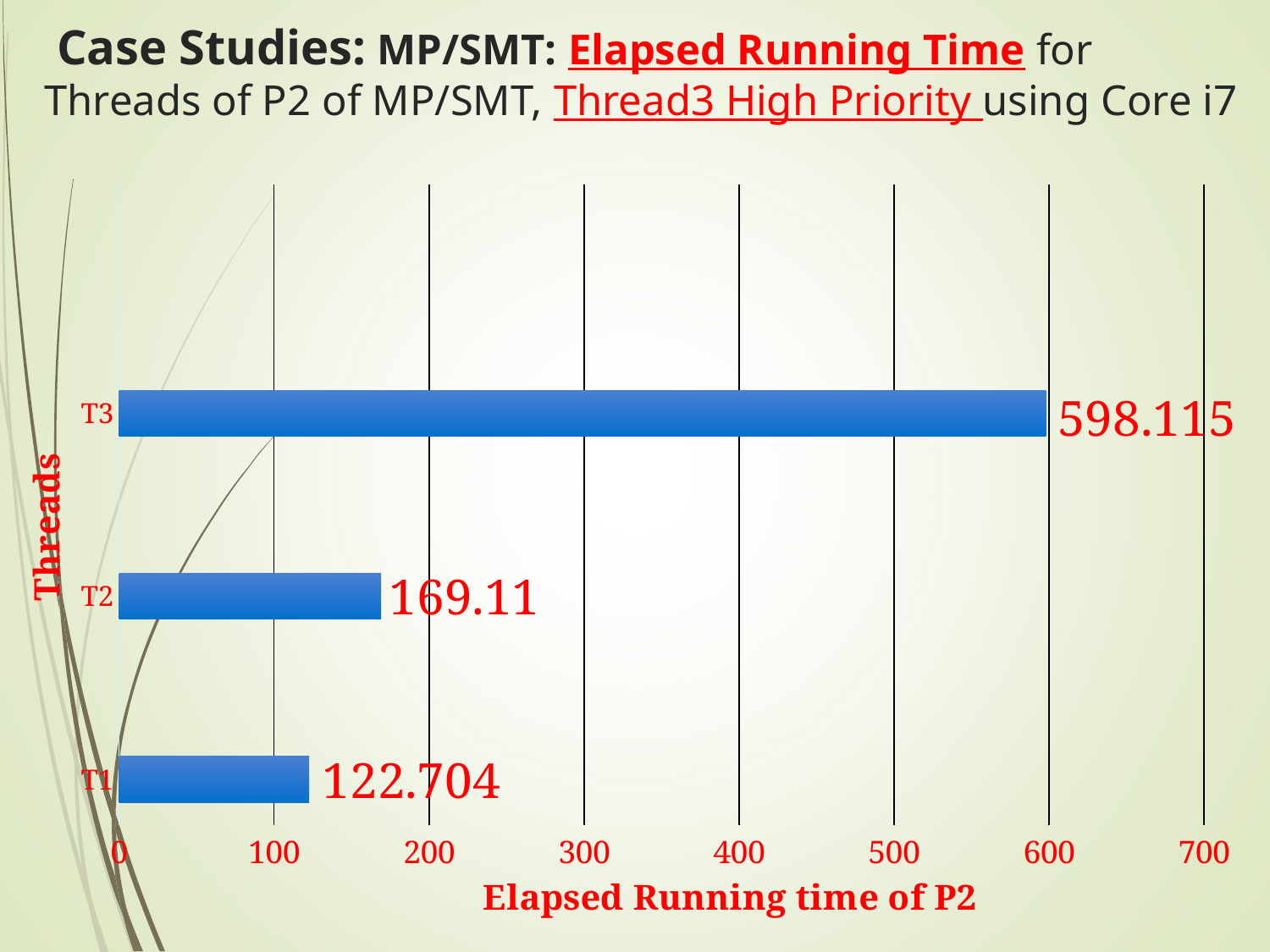
What kind of chart is shown on the slide? bar chart What is the elapsed running time for T1? 122.704 Which has a larger elapsed running time, T1 or T2? T2 What is the elapsed running time for T2? 169.11 How many threads are shown in the chart? 3 What is the elapsed running time for T3? 598.115 What is the label of the horizontal axis of the chart? Elapsed Running time of P2 Is the value for T3 greater or less than 500? greater Which thread has the lowest elapsed running time? T1 What is the difference between the elapsed running times of T2 and T1? 46.406 What is the difference between the elapsed running times of T3 and T2? 429.005 Which thread has the highest elapsed running time? T3